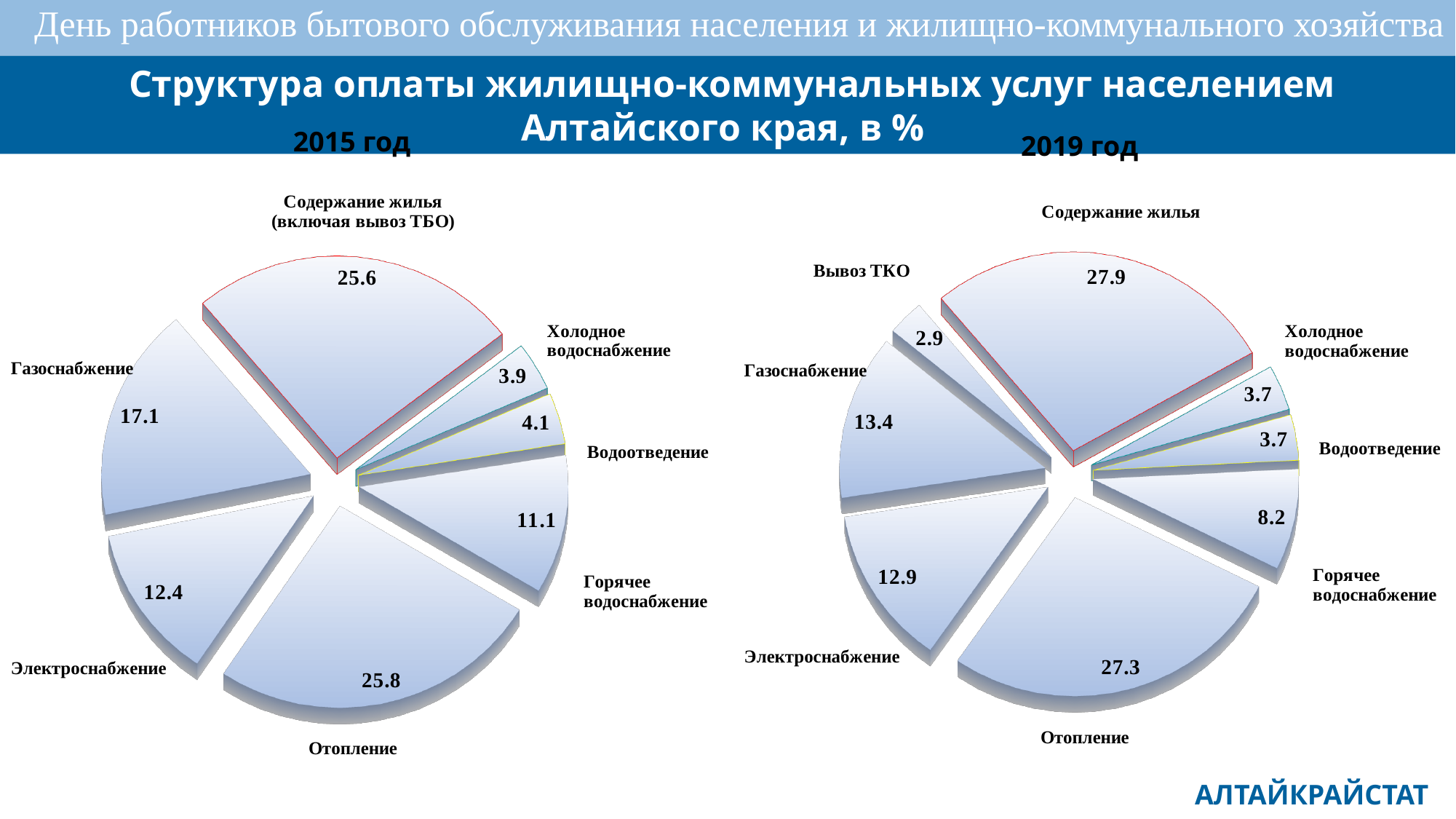
In the 2015 год chart, which category has the smallest share? Холодное водоснабжение In the 2019 год chart, what is the value for Вывоз ТКО? 2.9 In the 2019 год chart, which category has the smallest share? Вывоз ТКО In the 2019 год chart, which category has the largest share? Содержание жилья What type of chart is used for the 2015 год data? pie chart How many categories are shown in the 2019 год chart? 8 In the 2019 год chart, which is larger: Газоснабжение or Электроснабжение? Газоснабжение In the 2015 год chart, what is the value for Газоснабжение? 17.1 In the 2015 год chart, which category has the largest share? Отопление In the 2019 год chart, what is the value for Горячее водоснабжение? 8.2 How many categories are shown in the 2015 год chart? 7 What is the difference between the value for Отопление in the 2019 год chart and in the 2015 год chart? 1.5